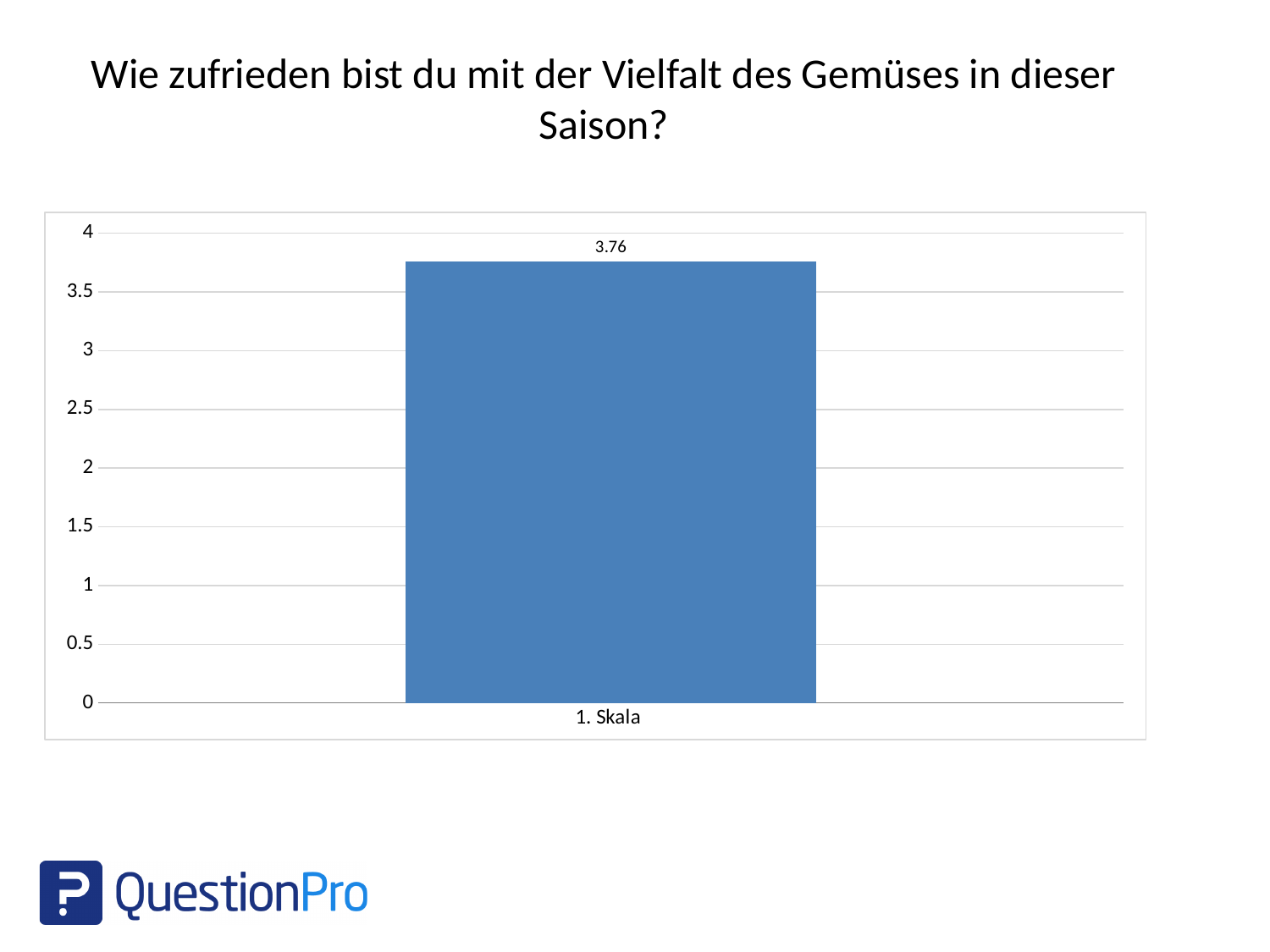
Is the value for "1. Skala" greater or less than 3.5? greater What is the label of the category on the x axis? 1. Skala How many bars does the chart show? 1 What is the highest value shown on the vertical axis? 4 What kind of chart is shown on the slide? bar chart Is the value for "1. Skala" greater or less than 4? less What is the title of the slide above the chart? Wie zufrieden bist du mit der Vielfalt des Gemüses in dieser Saison? What is the value shown for "1. Skala"? 3.76